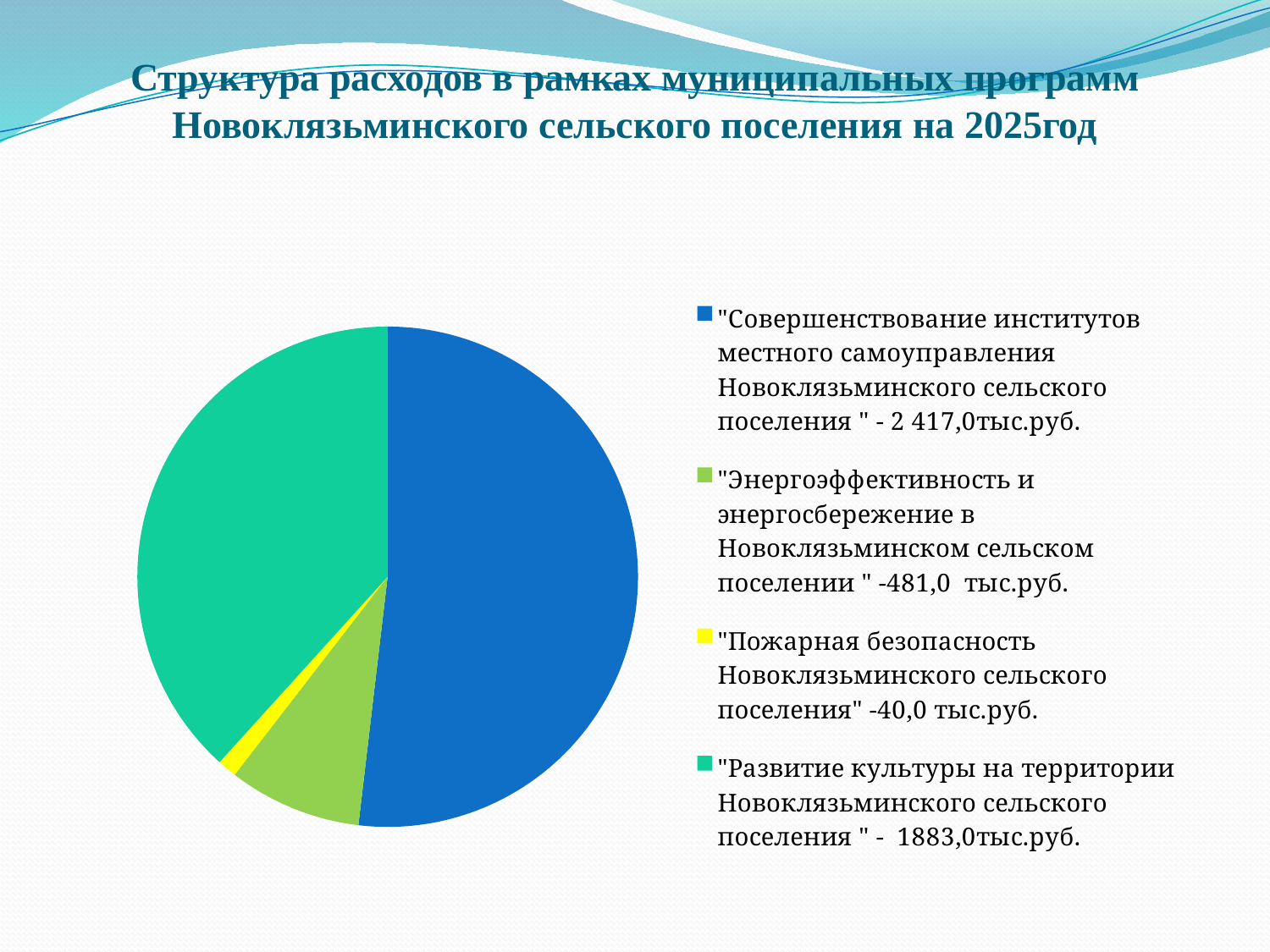
What kind of chart is shown on the slide? pie chart What is the value for "Энергоэффективность и энергосбережение в Новоклязьминском сельском поселении"? 481,0 тыс.руб. Which program has the smallest share of the pie? "Пожарная безопасность Новоклязьминского сельского поселения" How many entries does the legend of the pie chart list? 4 Which program has the largest share of the pie? "Совершенствование институтов местного самоуправления Новоклязьминского сельского поселения" What colour is the slice for "Пожарная безопасность Новоклязьминского сельского поселения"? yellow What is the difference between the value for "Совершенствование институтов местного самоуправления" and the value for "Развитие культуры"? 534,0 тыс.руб. What is the value for "Совершенствование институтов местного самоуправления Новоклязьминского сельского поселения"? 2 417,0 тыс.руб. How many slices does the pie chart have? 4 What is the value for "Развитие культуры на территории Новоклязьминского сельского поселения"? 1883,0 тыс.руб. What is the value for "Пожарная безопасность Новоклязьминского сельского поселения"? 40,0 тыс.руб. Which is larger: the value for "Энергоэффективность и энергосбережение" or the value for "Развитие культуры"? "Развитие культуры"